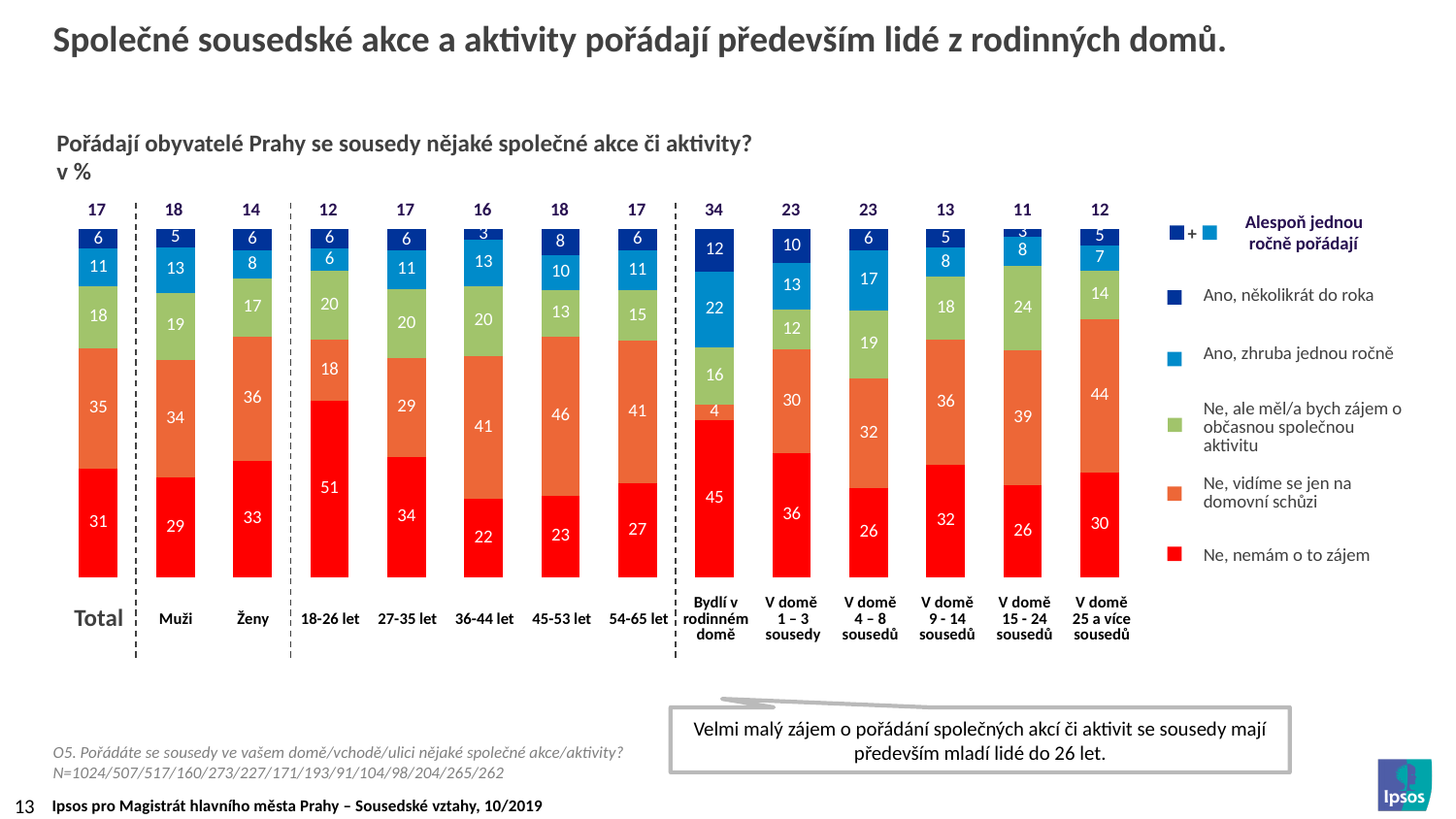
What is the value of "Ne, nemám o to zájem" for the 18-26 let category? 51 How many series does the legend list? 5 What is the difference between the "Ne, nemám o to zájem" values for Ženy and Muži? 4 What is the "Alespoň jednou ročně pořádají" figure shown above the bar for "Bydlí v rodinném domě"? 34 What is the value of "Ne, vidíme se jen na domovní schůzi" for the Total category? 35 What type of chart is shown on the slide? stacked bar chart Which has a larger "Ne, vidíme se jen na domovní schůzi" value: 45-53 let or 36-44 let? 45-53 let What is the value of "Ano, několikrát do roka" for the "Bydlí v rodinném domě" category? 12 Which category has the highest "Alespoň jednou ročně pořádají" figure shown above the bars? Bydlí v rodinném domě How many categories (bars) are shown along the x axis? 14 Which category has the lowest "Alespoň jednou ročně pořádají" figure shown above the bars? V domě 15 - 24 sousedů What is the value of "Ano, zhruba jednou ročně" for the "V domě 4 – 8 sousedů" category? 17